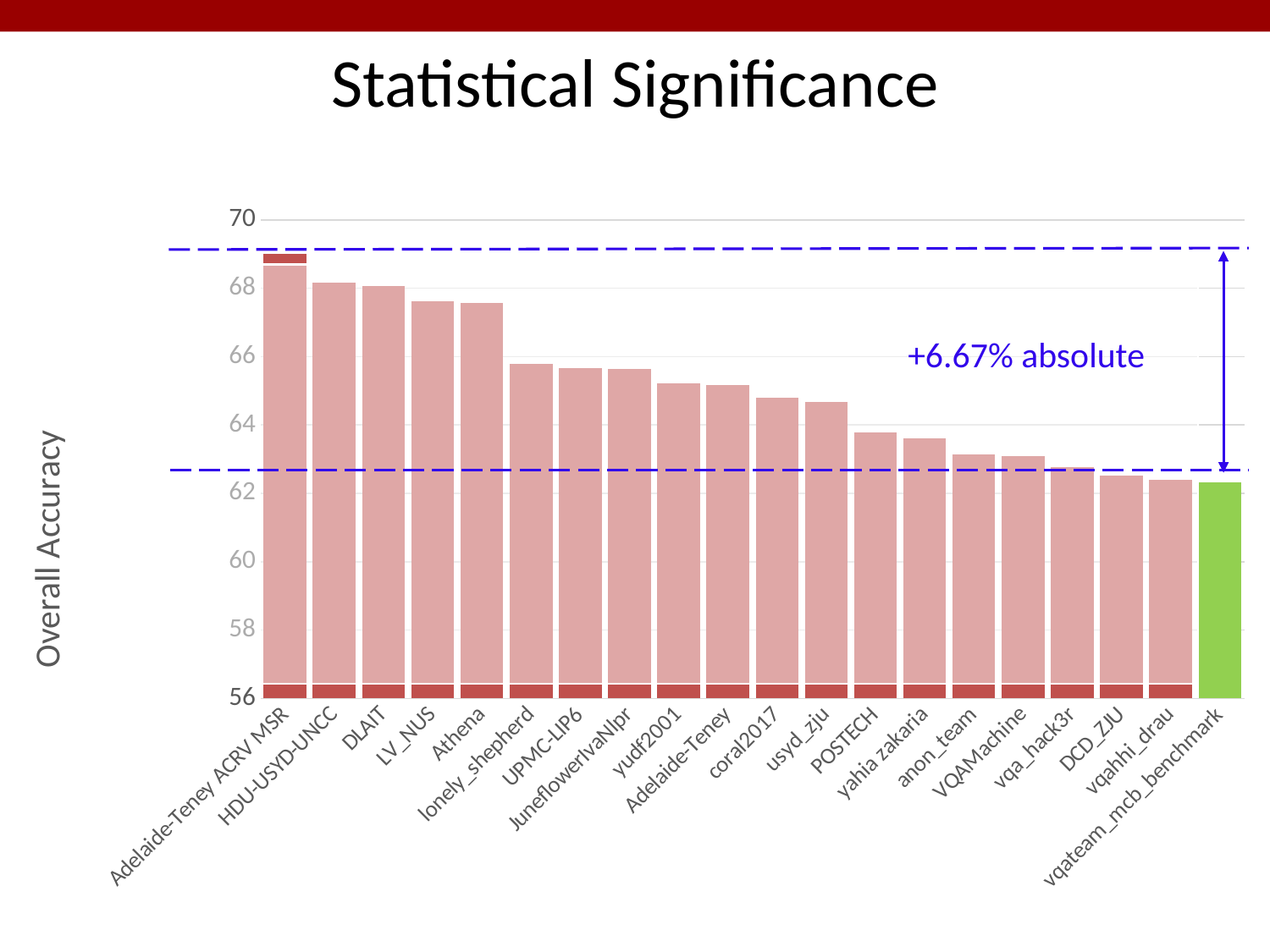
Which team has the highest overall accuracy in the chart? Adelaide-Teney ACRV MSR Is the value for vqateam_mcb_benchmark greater or less than 62? greater Is the value for lonely_shepherd greater or less than 66? less Which team has the lowest overall accuracy in the chart? vqateam_mcb_benchmark Is the value for LV_NUS greater or less than 68? less Which has a higher overall accuracy, Athena or POSTECH? Athena Do the bar values rise or fall from left to right along the x axis? fall What absolute improvement does the annotation between the two dashed lines state? +6.67% absolute How many teams (bars) are shown in the chart? 20 What kind of chart is shown on the slide? bar chart